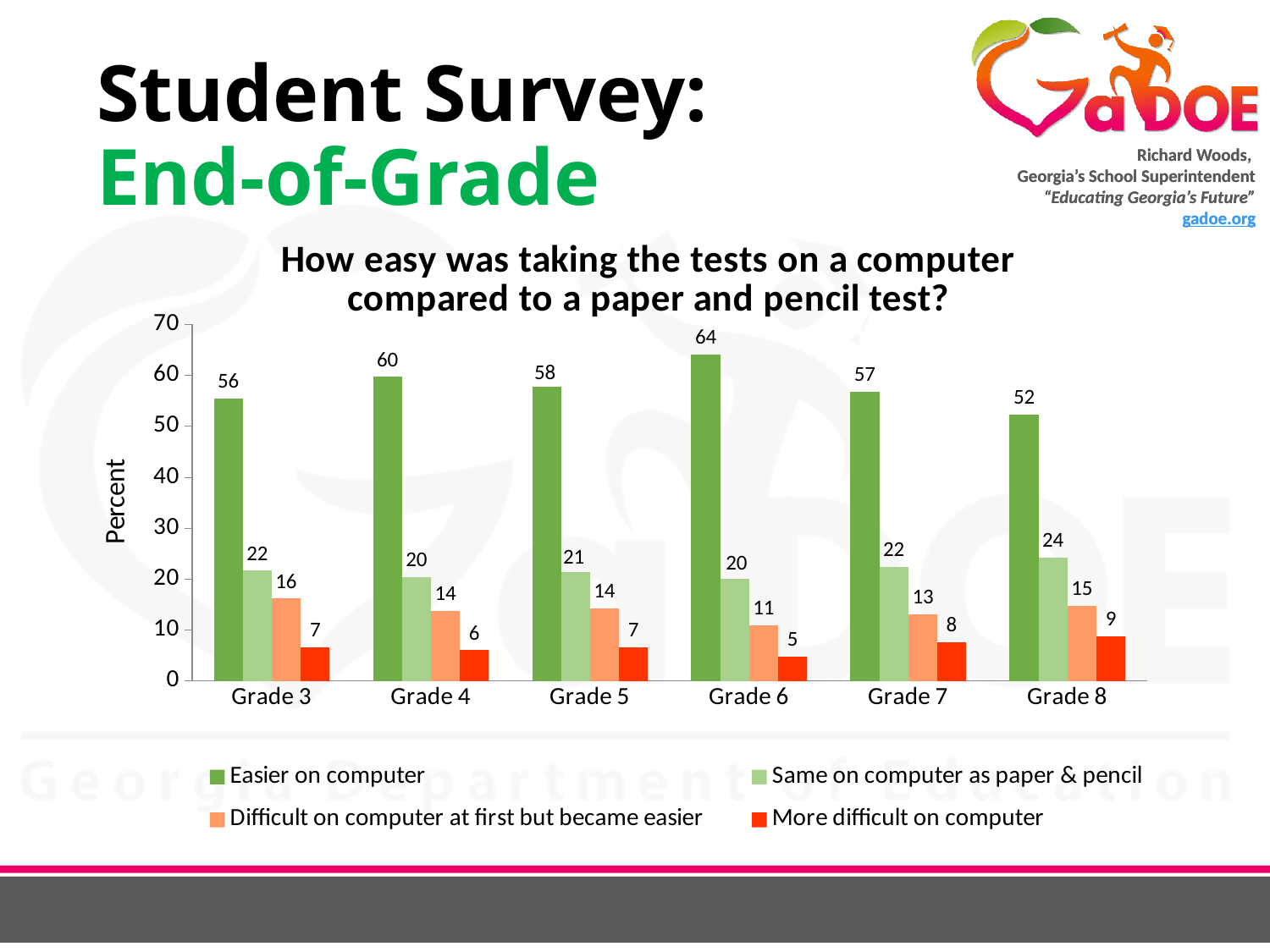
How many grades are shown on the x axis? 6 Which is larger: "Same on computer as paper & pencil" for Grade 8 or for Grade 4? Grade 8 Which grade has the lowest value for "More difficult on computer"? Grade 6 What is the value for "Difficult on computer at first but became easier" for Grade 3? 16 What is the label on the vertical axis? Percent What is the value for "Easier on computer" for Grade 6? 64 How many series does the legend list? 4 What is the value for "More difficult on computer" for Grade 8? 9 What is the title of the chart? How easy was taking the tests on a computer compared to a paper and pencil test? Which grade has the highest value for "Easier on computer"? Grade 6 What kind of chart is shown on the slide? Bar chart What is the difference between the "Easier on computer" values for Grade 6 and Grade 8? 12